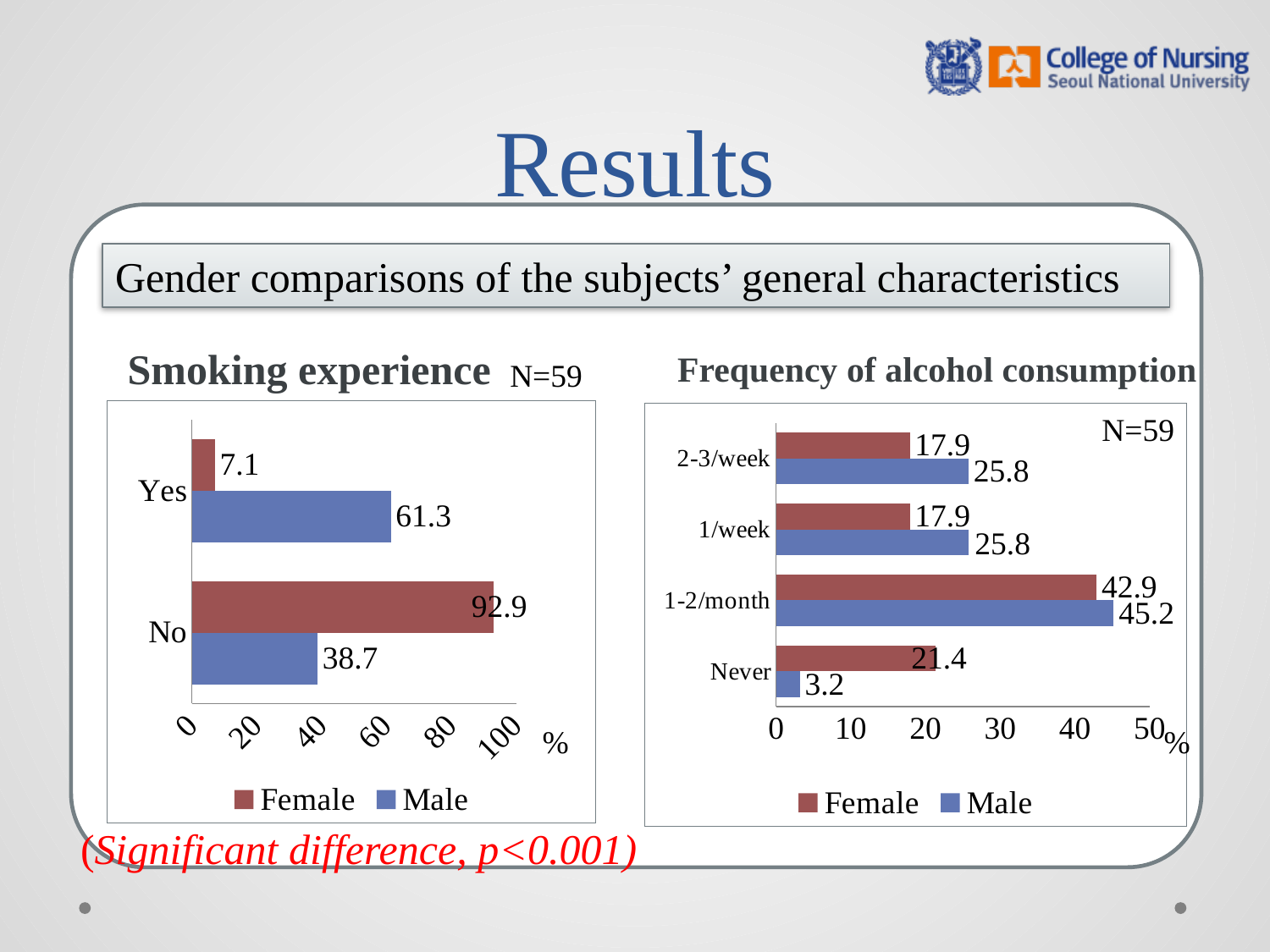
In the Smoking experience chart, what is the Male value for No? 38.7 In the Frequency of alcohol consumption chart, what is the difference between the Female and Male values for Never? 18.2 In the Smoking experience chart, how many series does the legend list? 2 In the Smoking experience chart, what is the Female value for Yes? 7.1 In the Frequency of alcohol consumption chart, what is the Male value for Never? 3.2 In the Frequency of alcohol consumption chart, how many categories are shown? 4 In the Smoking experience chart, what is the difference between the Female and Male values for No? 54.2 In the Frequency of alcohol consumption chart, which category has the lowest Female value? 2-3/week and 1/week (17.9) In the Frequency of alcohol consumption chart, what is the Female value for 1-2/month? 42.9 What kind of chart is the Smoking experience chart? Bar chart In the Frequency of alcohol consumption chart, which category has the highest Male value? 1-2/month In the Smoking experience chart, which is larger for Yes, Female or Male? Male